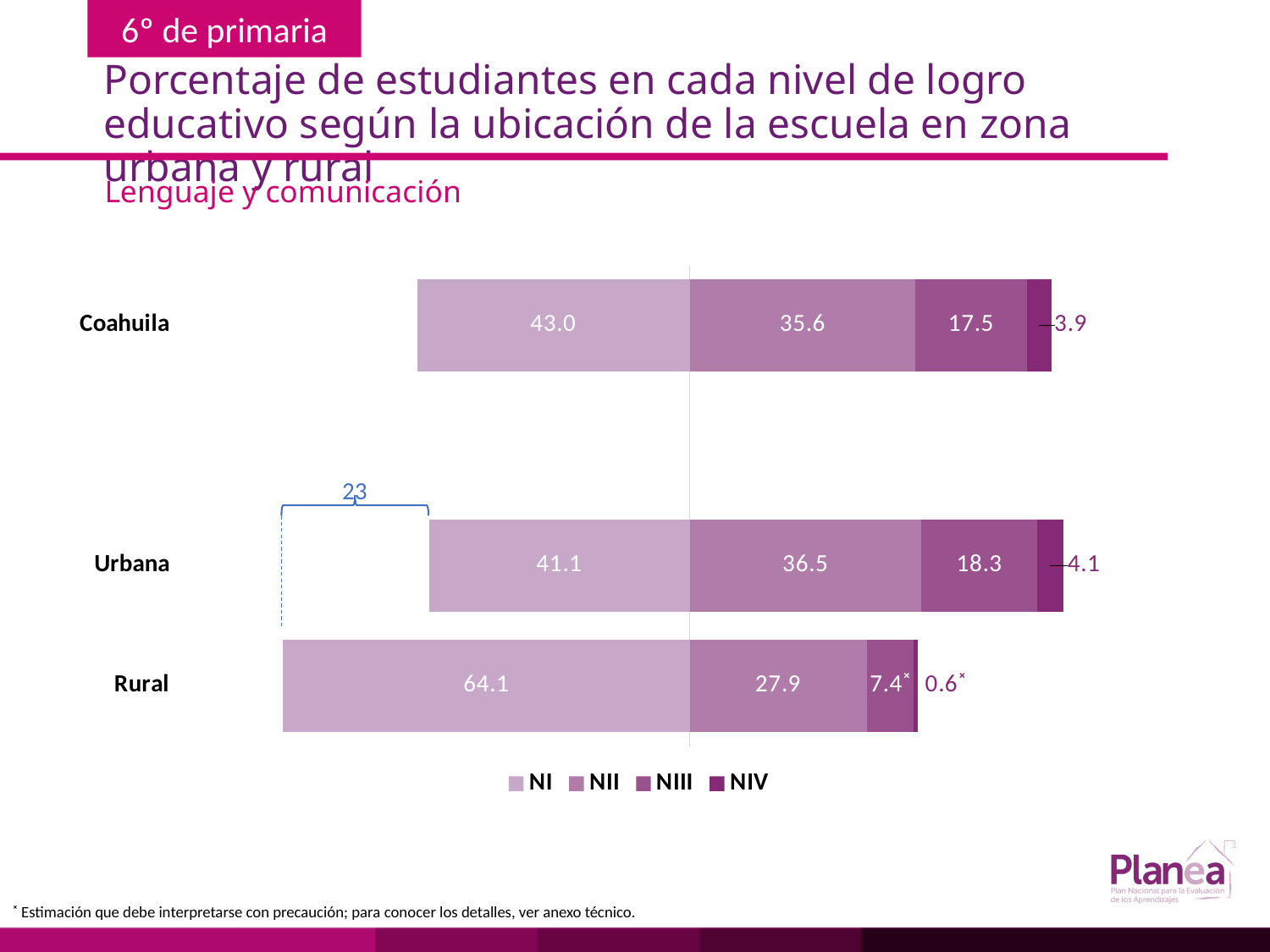
How many series does the legend list? 4 What kind of chart is shown on the slide? Stacked bar chart What is the NIV value for Rural? 0.6 What is the NII value for Coahuila? 35.6 What is the difference between the NI values for Rural and Urbana? 23 Which category has the lowest NIV value? Rural What is the NI value for Rural? 64.1 What is the NIII value for Urbana? 18.3 Which is larger, the NII value for Urbana or the NII value for Rural? Urbana What is the subtitle shown above the chart? Lenguaje y comunicación How many categories are shown on the chart? 3 Which category has the highest NI value? Rural